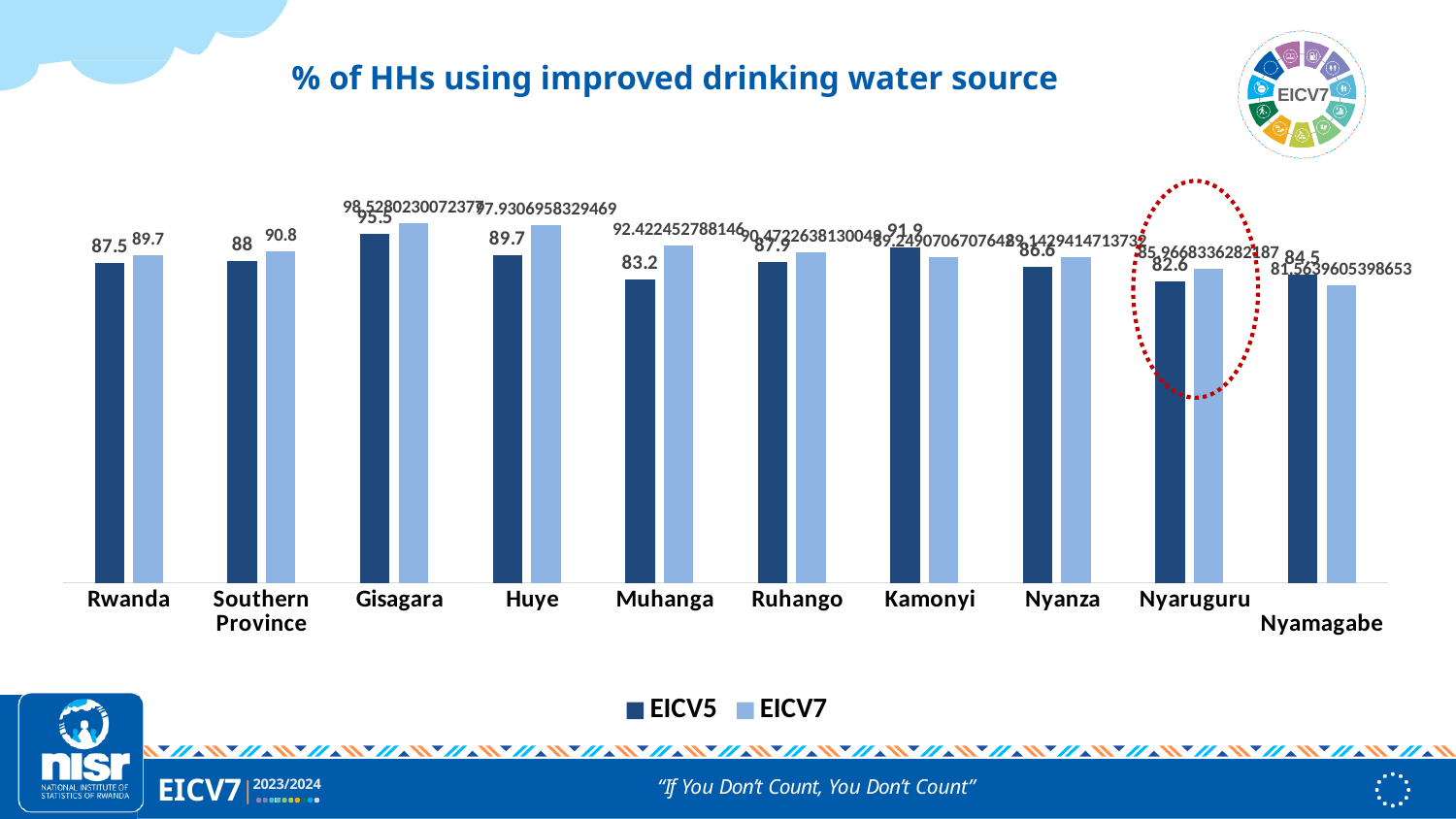
What kind of chart is shown on the slide? Bar chart What is the EICV7 value for Southern Province? 90.8 What is the EICV5 value for Kamonyi? 91.9 What is the EICV5 value for Muhanga? 83.2 What is the EICV5 value for Rwanda? 87.5 What is the difference between the EICV7 and EICV5 values for Southern Province? 2.8 Which category has the lowest EICV5 value? Nyaruguru What is the difference between the EICV7 and EICV5 values for Rwanda? 2.2 How many categories are shown on the x axis? 10 How many series does the legend list? 2 Which category has the highest EICV5 value? Gisagara For Nyamagabe, which series has the larger value, EICV5 or EICV7? EICV5